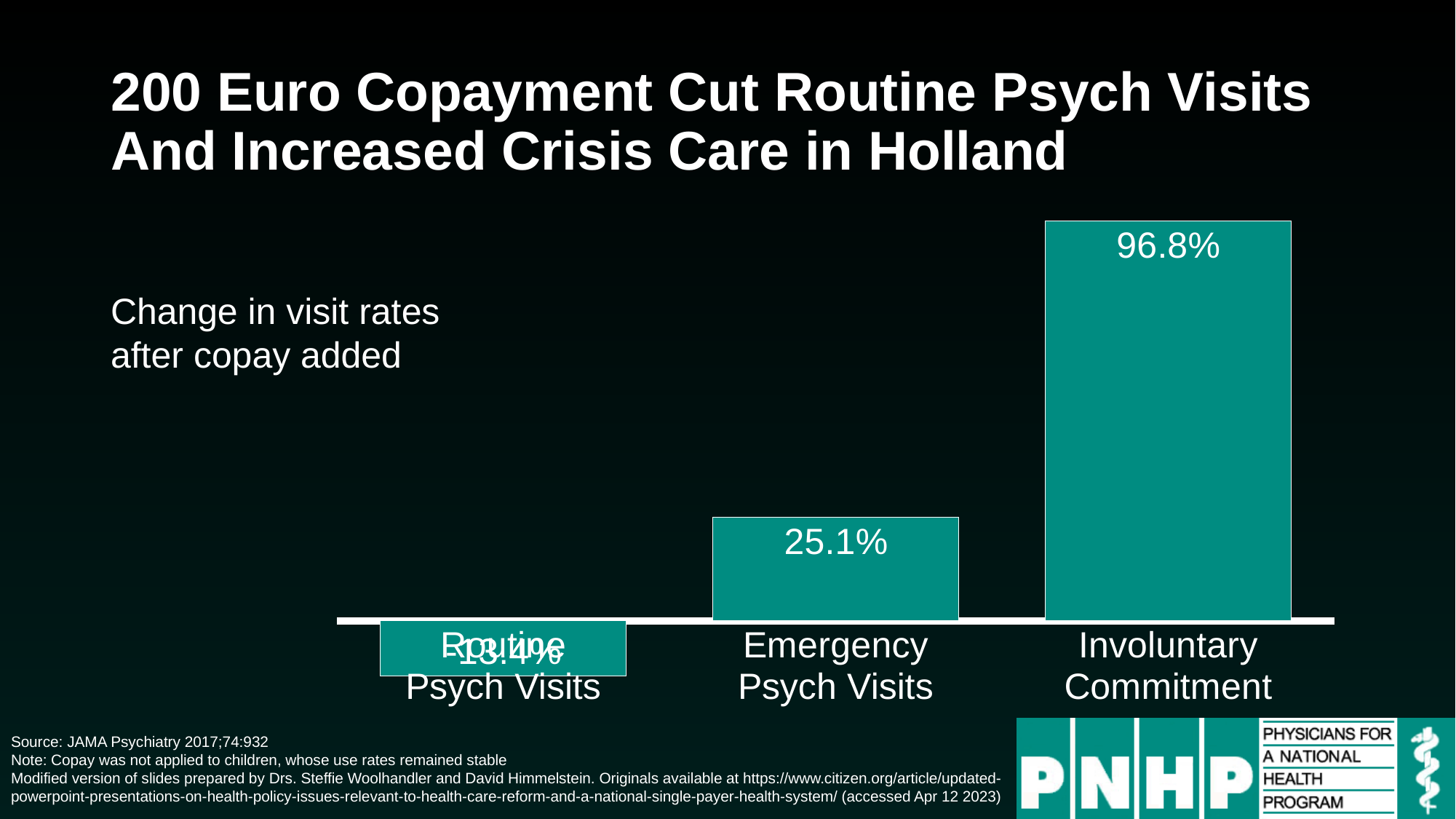
What is the difference between the values for Involuntary Commitment and Emergency Psych Visits? 71.7% Which category has the lowest value? Routine Psych Visits Which category's bar extends below the baseline, indicating a decrease? Routine Psych Visits What is the value for Emergency Psych Visits? 25.1% Do the values rise or fall from left to right across the categories? Rise How many categories are shown in the chart? 3 What kind of chart is shown on the slide? Bar chart Which category has the highest value? Involuntary Commitment What does the text to the left of the chart say the bars represent? Change in visit rates after copay added Which is larger, the value for Emergency Psych Visits or the value for Involuntary Commitment? Involuntary Commitment What is the value for Involuntary Commitment? 96.8%